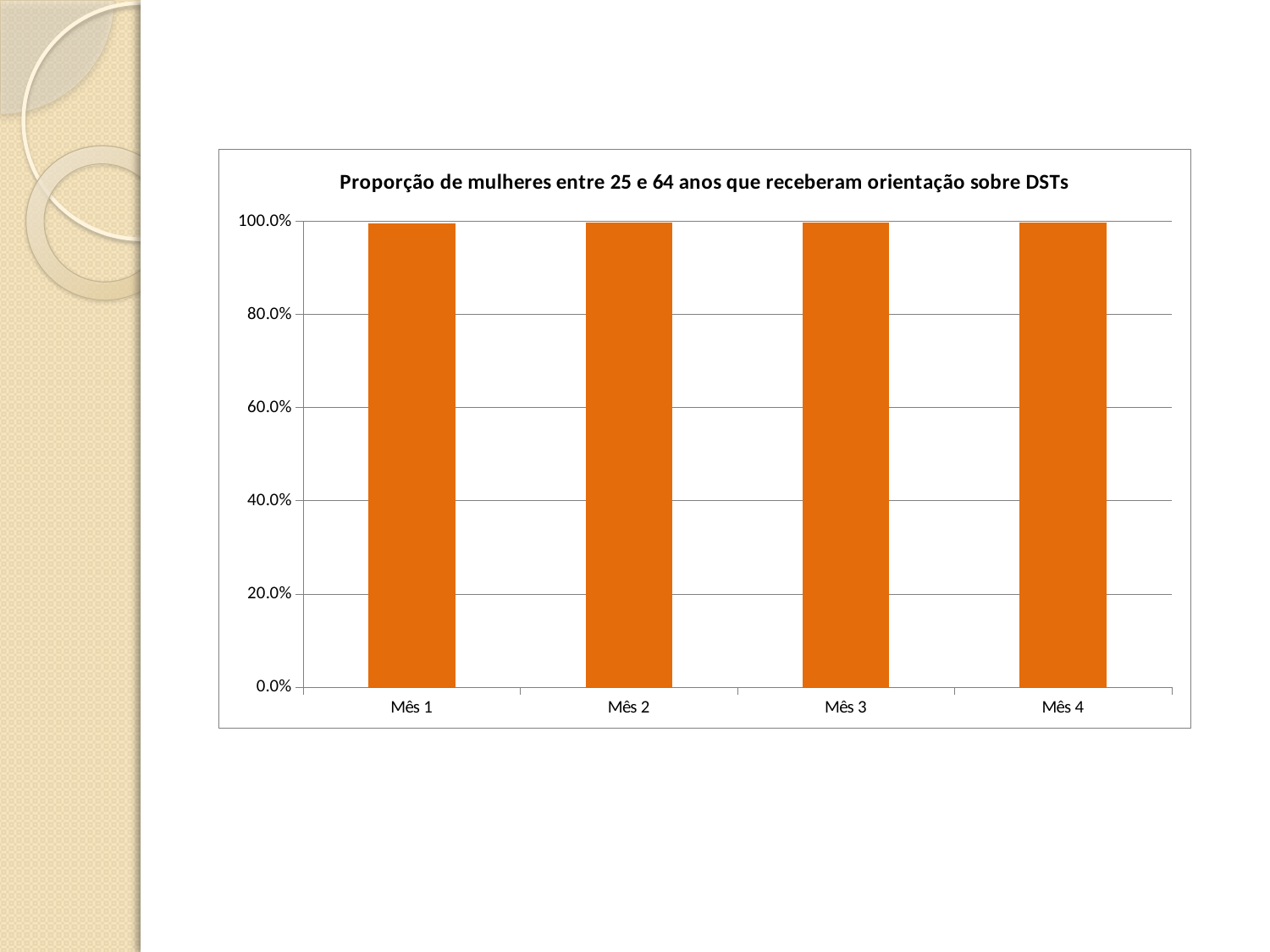
Is the value for Mês 3 greater or less than 80.0%? greater Is the value for Mês 2 greater or less than 60.0%? greater What is the title of the chart? Proporção de mulheres entre 25 e 64 anos que receberam orientação sobre DSTs How many categories are shown on the x axis of the chart? 4 What is the highest value shown on the y axis of the chart? 100.0% What kind of chart is shown on the slide? bar chart Is the value for Mês 1 greater or less than 80.0%? greater What is the label of the first category on the x axis? Mês 1